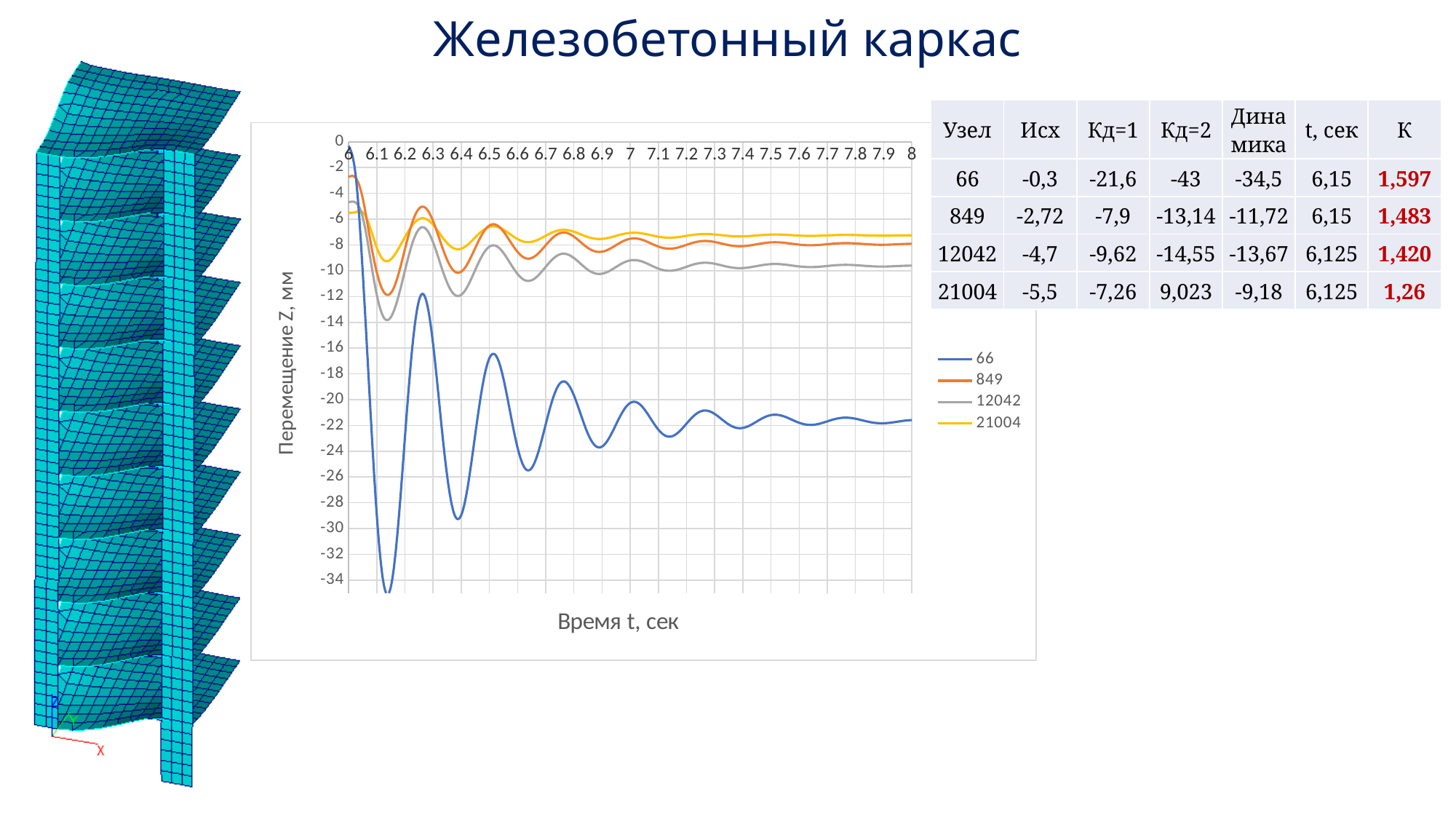
Which series stays closest to zero (highest) throughout the chart? 21004 At t = 8, which series has the higher value, 849 or 12042? 849 Is the value of series 21004 at t = 8 greater or less than -10? greater What are the series names listed in the chart legend? 66, 849, 12042, 21004 How many series does the chart legend list? 4 Is the lowest value reached by series 66 greater or less than -30? less What is the title of the chart's x axis? Время t, сек Which series reaches the lowest displacement value on the chart? 66 Does the amplitude of oscillation of series 66 increase or decrease as time goes from 6 to 8 seconds? decrease Is the value of series 12042 at t = 8 greater or less than -12? greater What kind of chart is shown on the slide? line chart